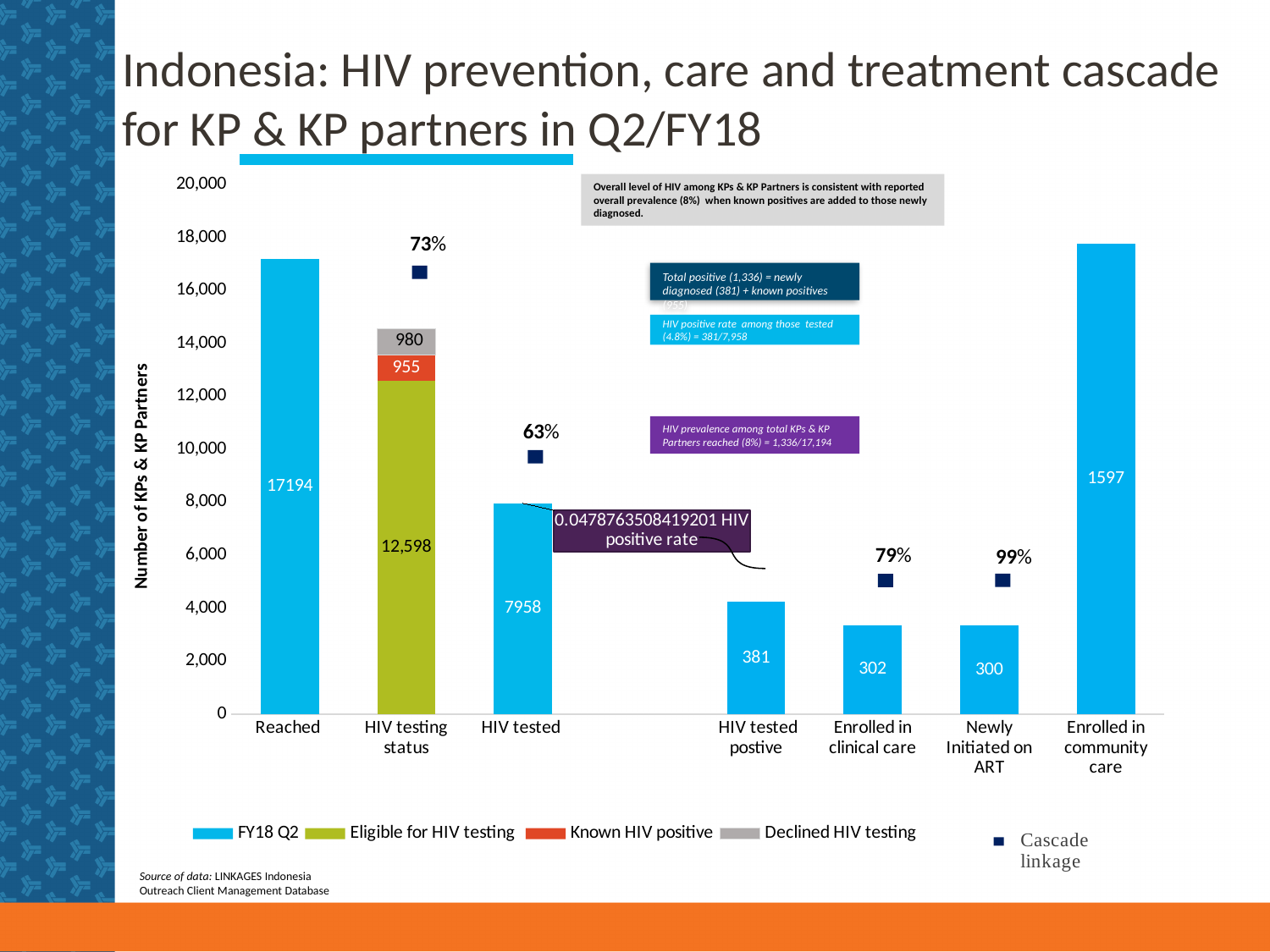
Which is larger, the value for HIV tested positive or the value for Newly Initiated on ART? HIV tested positive What is the value for HIV tested? 7958 What is the total of the stacked HIV testing status bar? 14,533 What is the value for the Reached category? 17194 What is the Eligible for HIV testing value in the HIV testing status bar? 12,598 What is the Declined HIV testing value in the HIV testing status bar? 980 What is the difference between the HIV tested positive value and the Enrolled in clinical care value? 79 How many series does the legend at the bottom of the chart list? 4 What kind of chart is shown on the slide? Bar chart What is the difference between the Reached value and the HIV tested value? 9236 How many categories are shown on the x axis? 7 What is the value for Enrolled in community care? 1597